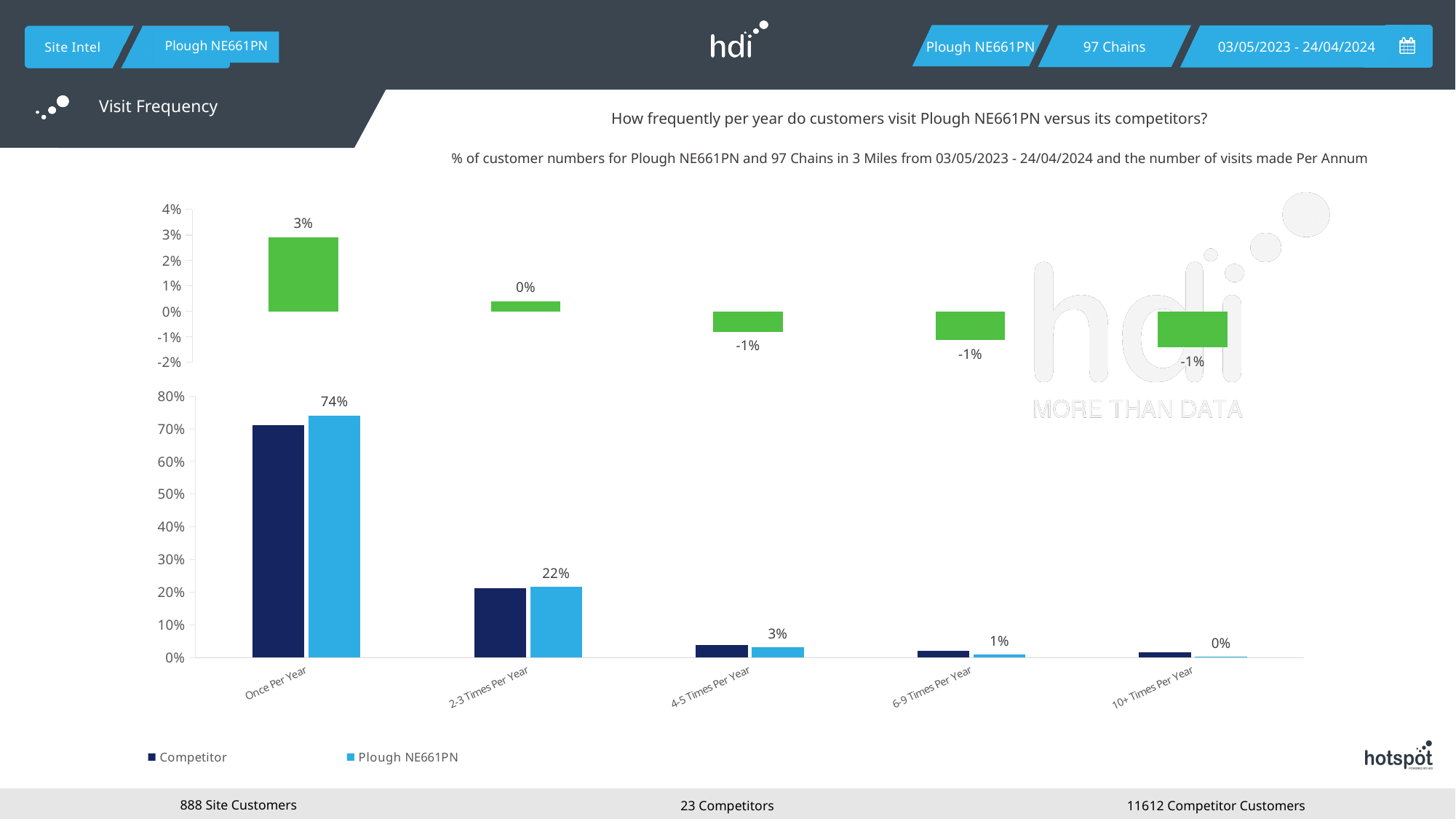
In the bottom chart, what is the value for Plough NE661PN for 10+ Times Per Year? 0% How many categories are shown on the x axis of the bottom chart? 5 In the top chart, which category has the highest value? Once Per Year In the top chart, what is the value for 6-9 Times Per Year? -1% In the bottom chart, what is the difference between the Plough NE661PN values for Once Per Year and 2-3 Times Per Year? 52% In the bottom chart, what is the value for Plough NE661PN for 2-3 Times Per Year? 22% In the bottom chart, how many series does the legend list? 2 In the bottom chart, which category has the highest value for Plough NE661PN? Once Per Year In the bottom chart, what is the value for Plough NE661PN for 4-5 Times Per Year? 3% In the bottom chart, what is the value for Plough NE661PN for Once Per Year? 74% In the top chart, what is the value for Once Per Year? 3% In the bottom chart, is the Competitor value for Once Per Year greater or less than 60%? greater